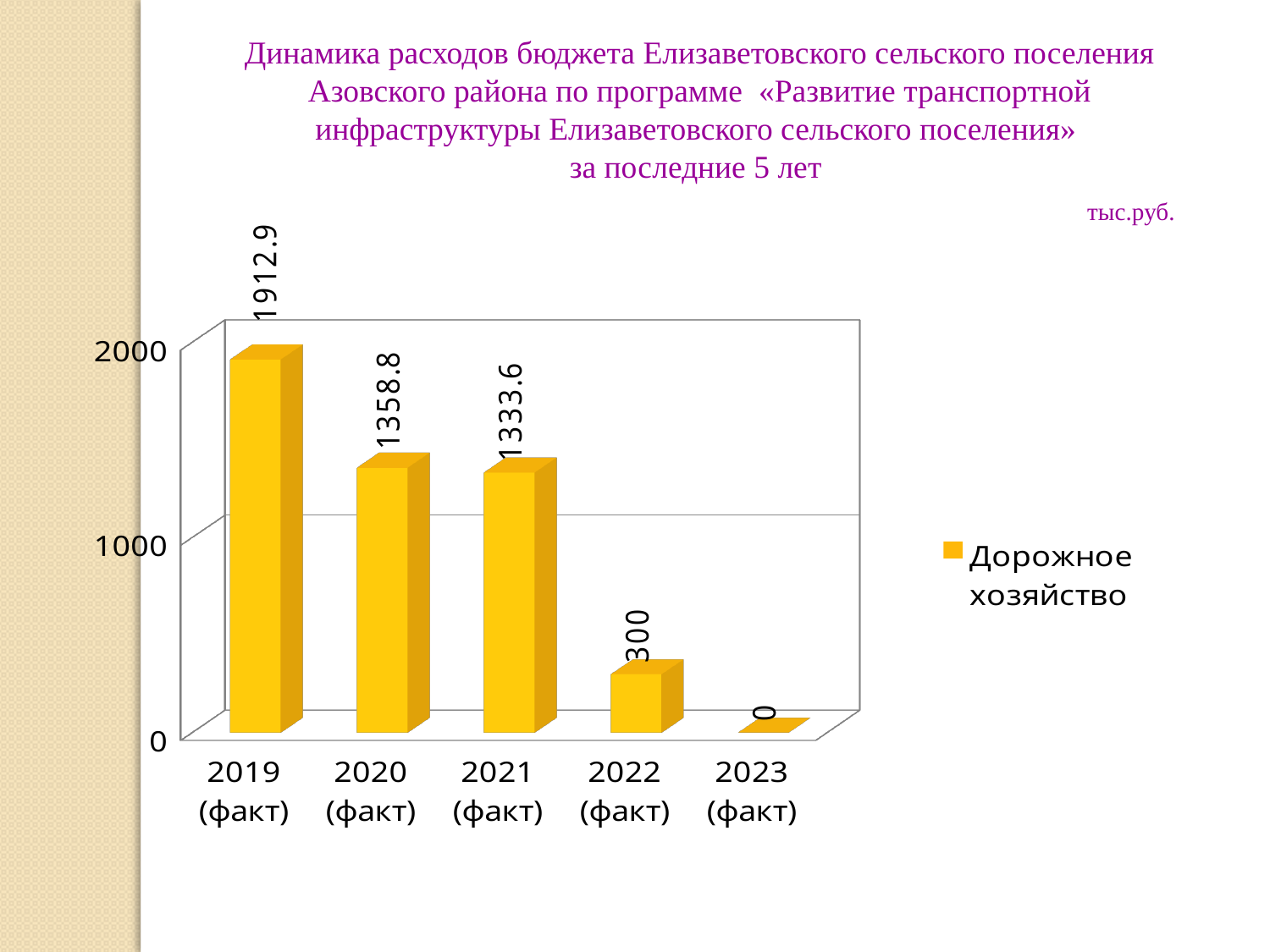
Which year has the lowest value? 2023 (факт) Which year has the highest value? 2019 (факт) What is the value for 2021 (факт)? 1333.6 What is the value for 2023 (факт)? 0 Which is larger, the value for 2021 (факт) or the value for 2022 (факт)? 2021 (факт) What kind of chart is this? bar chart What is the value for 2020 (факт)? 1358.8 What is the value for 2019 (факт)? 1912.9 Do the values rise or fall from 2019 to 2023? fall What is the value for 2022 (факт)? 300 How many years are shown on the x axis? 5 What is the difference between the values for 2019 (факт) and 2020 (факт)? 554.1